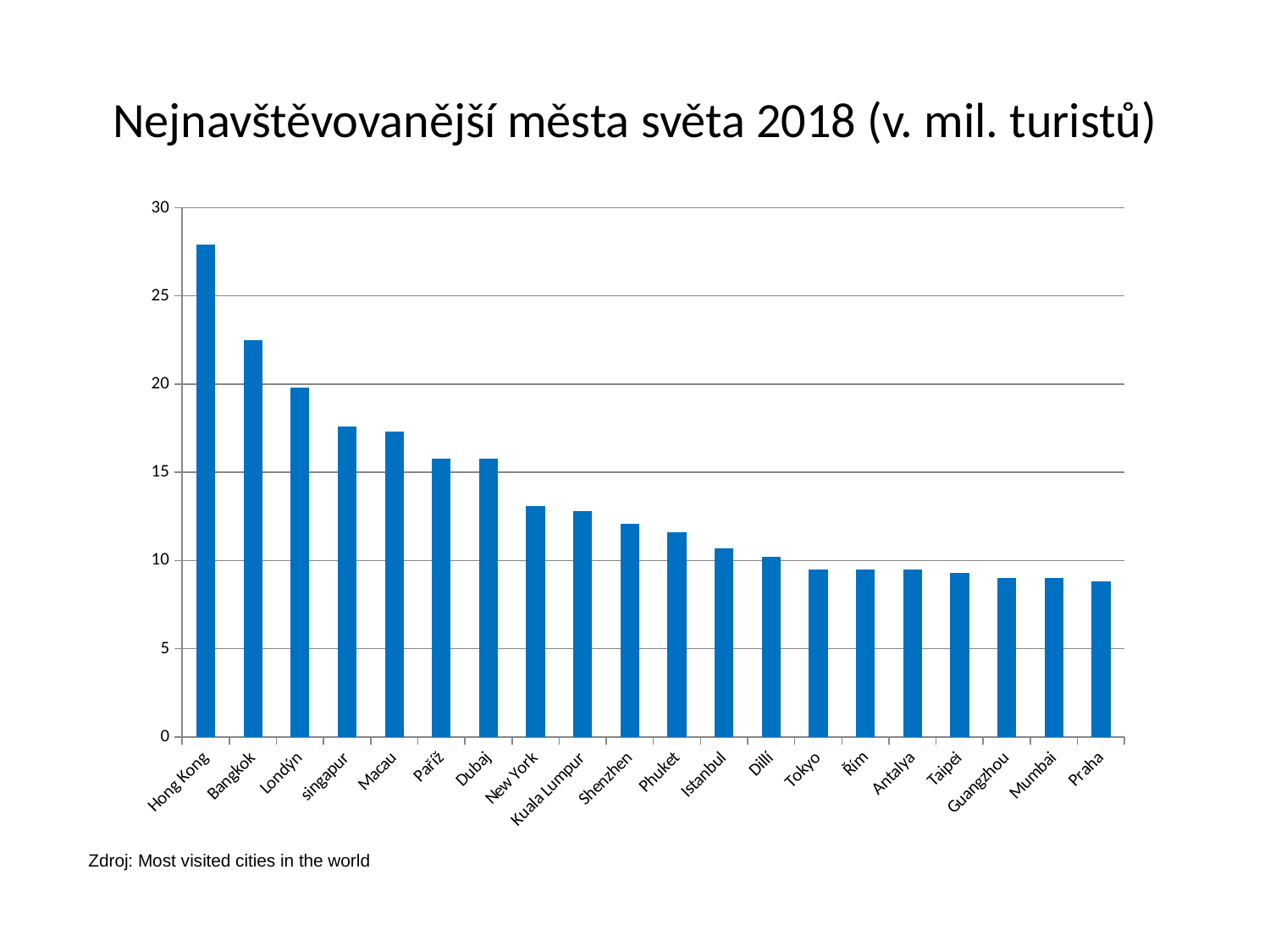
Is the value for Tokyo greater or less than 10? less Is the value for Macau greater or less than 15? greater What kind of chart is shown on the slide? bar chart Which has a larger value, Bangkok or Londýn? Bangkok What is the title of the chart? Nejnavštěvovanější města světa 2018 (v. mil. turistů) Which has a larger value, Shenzhen or Phuket? Shenzhen Is the value for Bangkok greater or less than 20? greater Which city has the highest bar in the chart? Hong Kong How many cities are shown on the x axis of the chart? 20 Do the bar values rise or fall from left to right along the x axis? fall